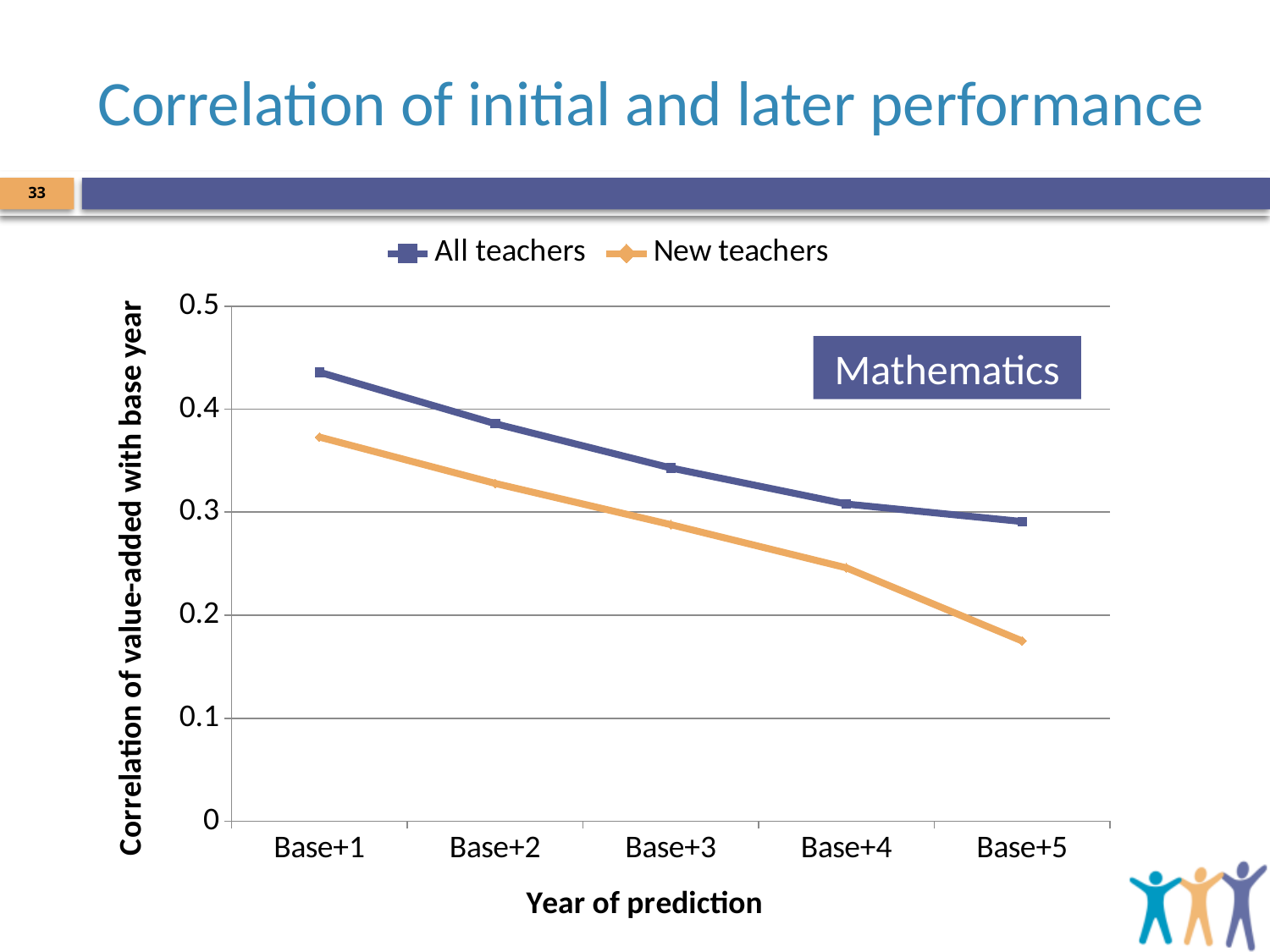
How many years of prediction are plotted along the x axis? 5 How many series does the legend list? 2 At which year of prediction is the New teachers correlation lowest? Base+5 Is the value for New teachers at Base+5 greater or less than 0.2? less What kind of chart is shown on the slide? Line chart Is the value for All teachers at Base+1 greater or less than 0.4? greater At Base+5, which series has the larger correlation, All teachers or New teachers? All teachers At which year of prediction is the All teachers correlation highest? Base+1 Is the value for New teachers at Base+4 greater or less than 0.3? less Do the values for All teachers rise or fall from Base+1 to Base+5? Fall Do the values for New teachers rise or fall from Base+1 to Base+5? Fall Which subject is named in the label box inside the chart? Mathematics